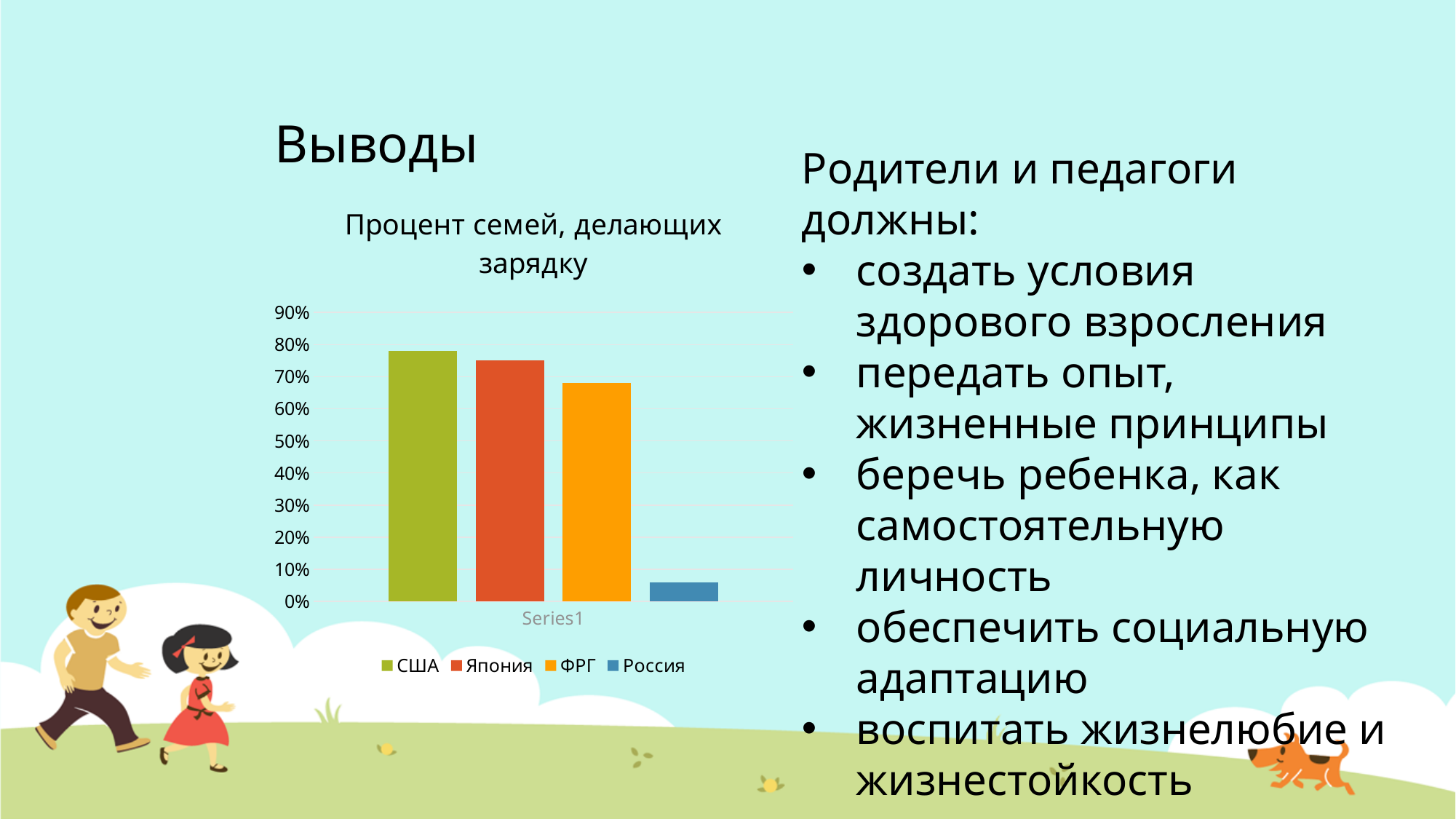
Which is larger, the value for Россия or the value for Япония? Япония What kind of chart is shown on the slide? bar chart Which series has the highest value in the chart? США Which series has the lowest value in the chart? Россия What is the title of the chart? Процент семей, делающих зарядку Is the value for США greater or less than 70%? greater What colour is the bar for Россия? blue Is the value for ФРГ greater or less than 60%? greater Do the bar values rise or fall from left to right across the chart? fall How many series does the chart legend list? 4 Which is larger, the value for США or the value for ФРГ? США Is the value for Россия greater or less than 10%? less